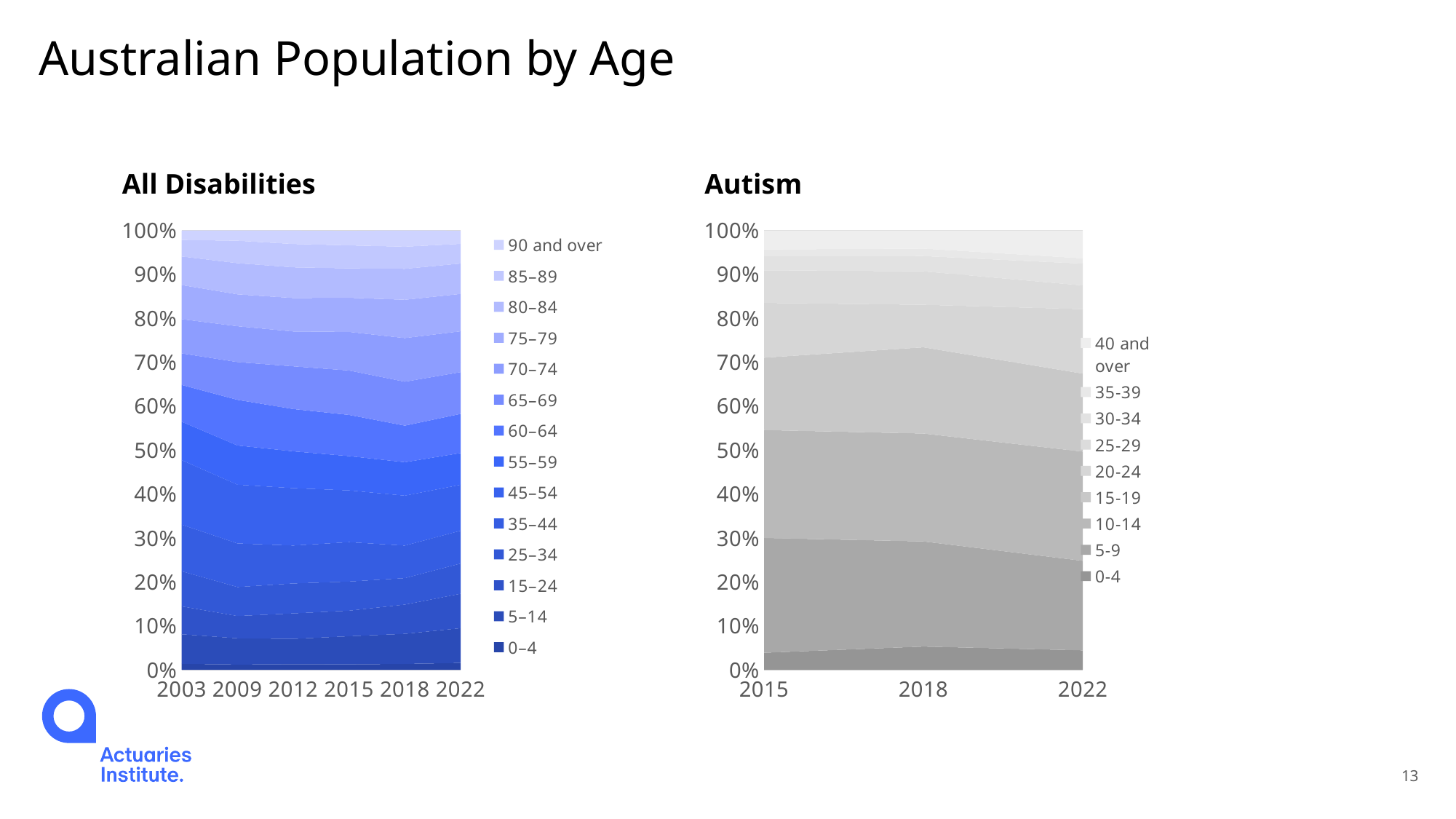
How many age groups does the legend of the Autism chart list? 9 In the All Disabilities chart, is the share of the 0-4 age group in 2003 greater or less than 20%? less In the Autism chart, is the share of the 0-4 age group in 2015 greater or less than 10%? less How many age groups does the legend of the All Disabilities chart list? 14 What kind of chart is the Autism chart? stacked area chart What is the oldest age group listed in the legend of the Autism chart? 40 and over What is the first year shown on the x axis of the All Disabilities chart? 2003 What kind of chart is the All Disabilities chart? stacked area chart In the Autism chart, does the share of the 0-4 age group rise or fall from 2015 to 2022? rise How many years are shown on the x axis of the Autism chart? 3 How many years are shown on the x axis of the All Disabilities chart? 6